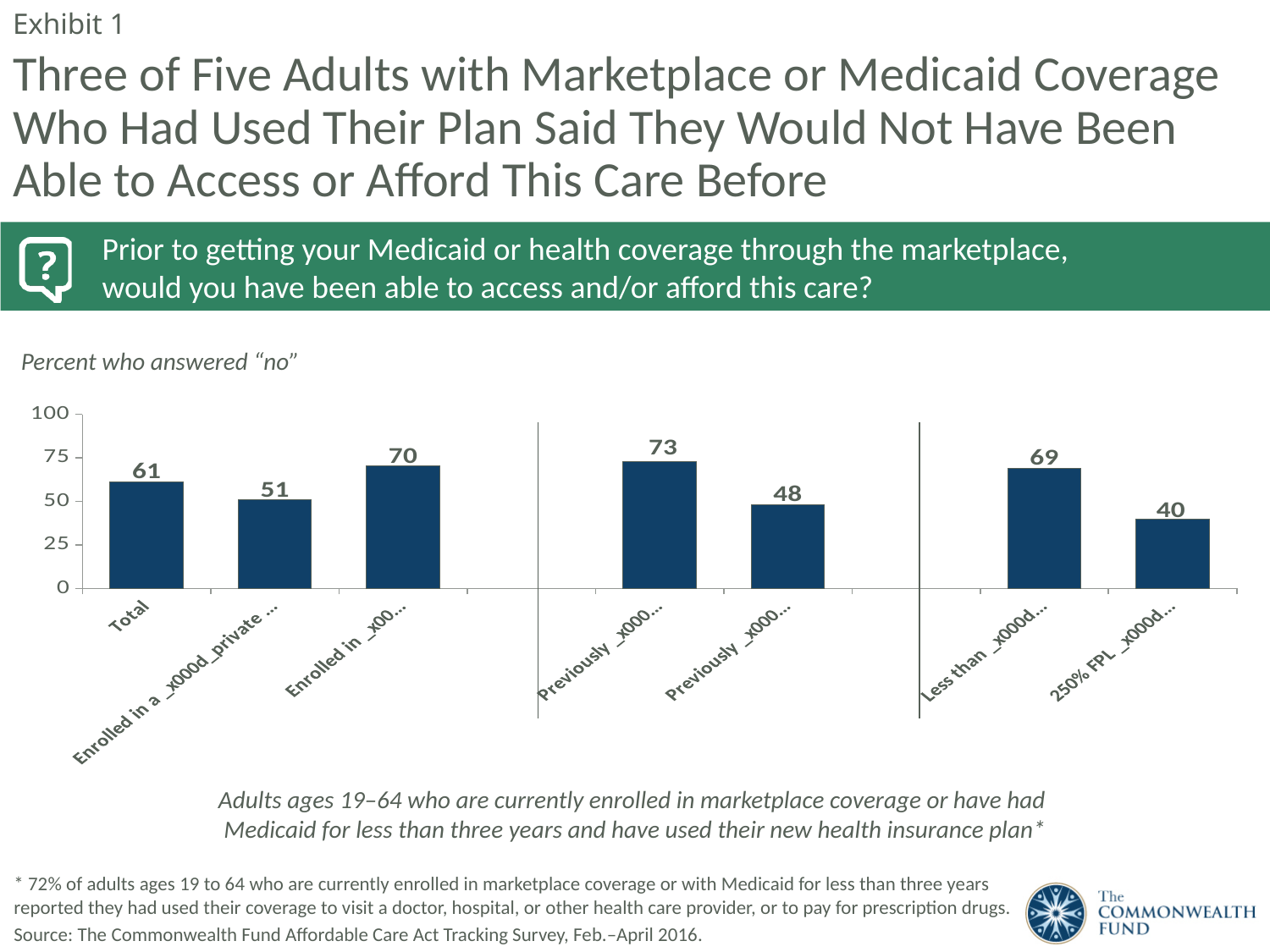
What is the highest value shown on the chart? 73 How much higher is the Total value than the lowest value on the chart? 21 What is the difference between the highest and lowest values on the chart? 33 What is the maximum value shown on the vertical axis? 100 What does the chart measure, according to the label above it? Percent who answered "no" How many bars have a value above 60? 4 How many bars are plotted on the chart? 7 Is the value for Total greater or less than 50? greater What is the value of the Total bar? 61 What kind of chart is shown on the slide? Bar chart What is the lowest value shown on the chart? 40 How many bars have a value below 50? 2